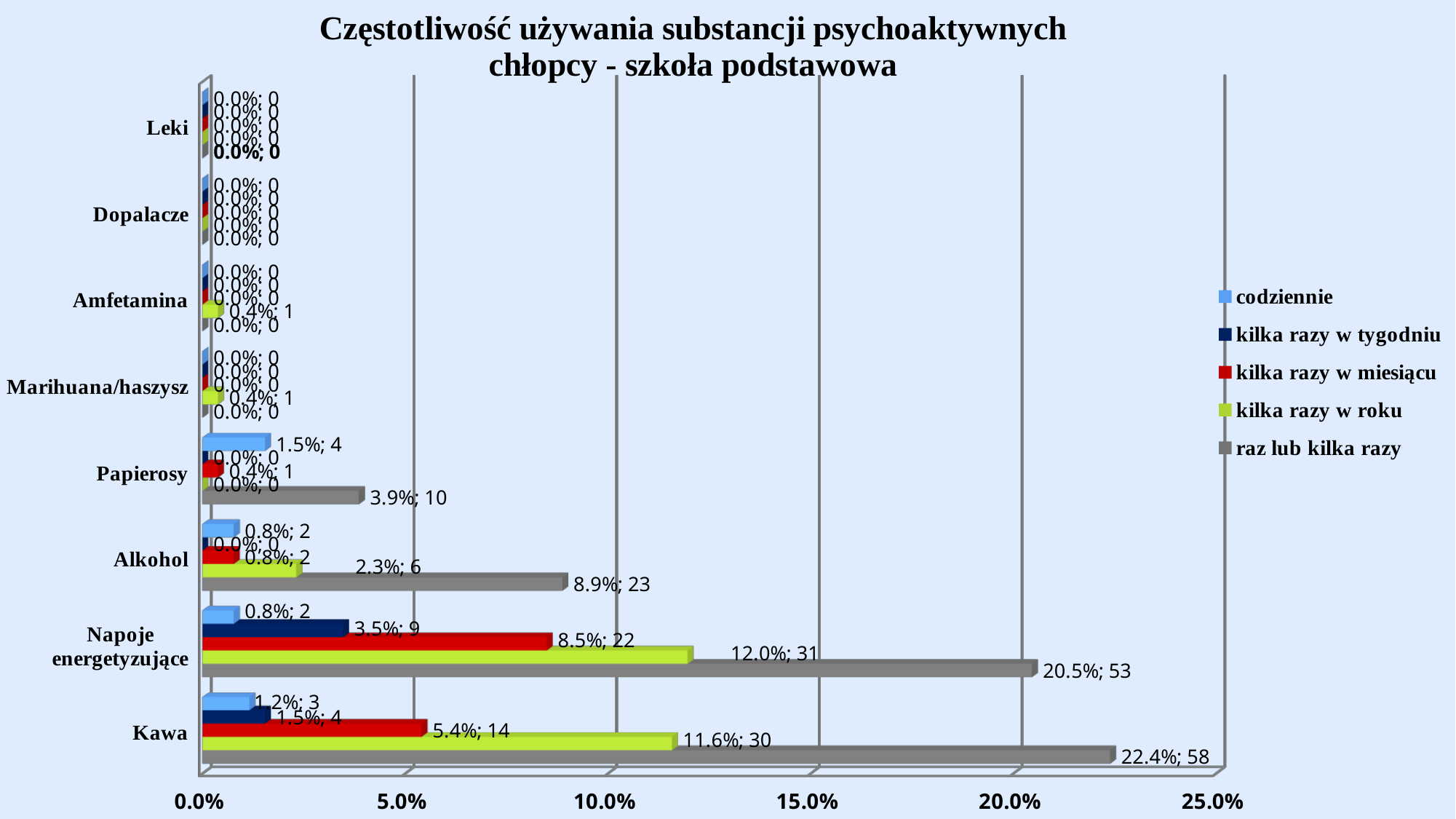
What is the percentage for Kawa in the 'raz lub kilka razy' series? 22.4% What is the percentage for Napoje energetyzujące in the 'kilka razy w roku' series? 12.0% What is the difference in percentage points between the 'raz lub kilka razy' values for Kawa and Napoje energetyzujące? 1.9 Which is larger: the 'kilka razy w miesiącu' value for Kawa or for Napoje energetyzujące? Napoje energetyzujące What is the percentage for Papierosy in the 'codziennie' series? 1.5% What kind of chart is shown on the slide? bar chart Is the 'raz lub kilka razy' value for Napoje energetyzujące greater or less than 20.0%? greater Which category has the highest value in the 'raz lub kilka razy' series? Kawa How many series does the legend list? 5 How many respondents (count) are shown for Alkohol in the 'raz lub kilka razy' series? 23 How many substance categories are shown on the y axis? 8 Which colour represents the 'kilka razy w roku' series in the legend? green